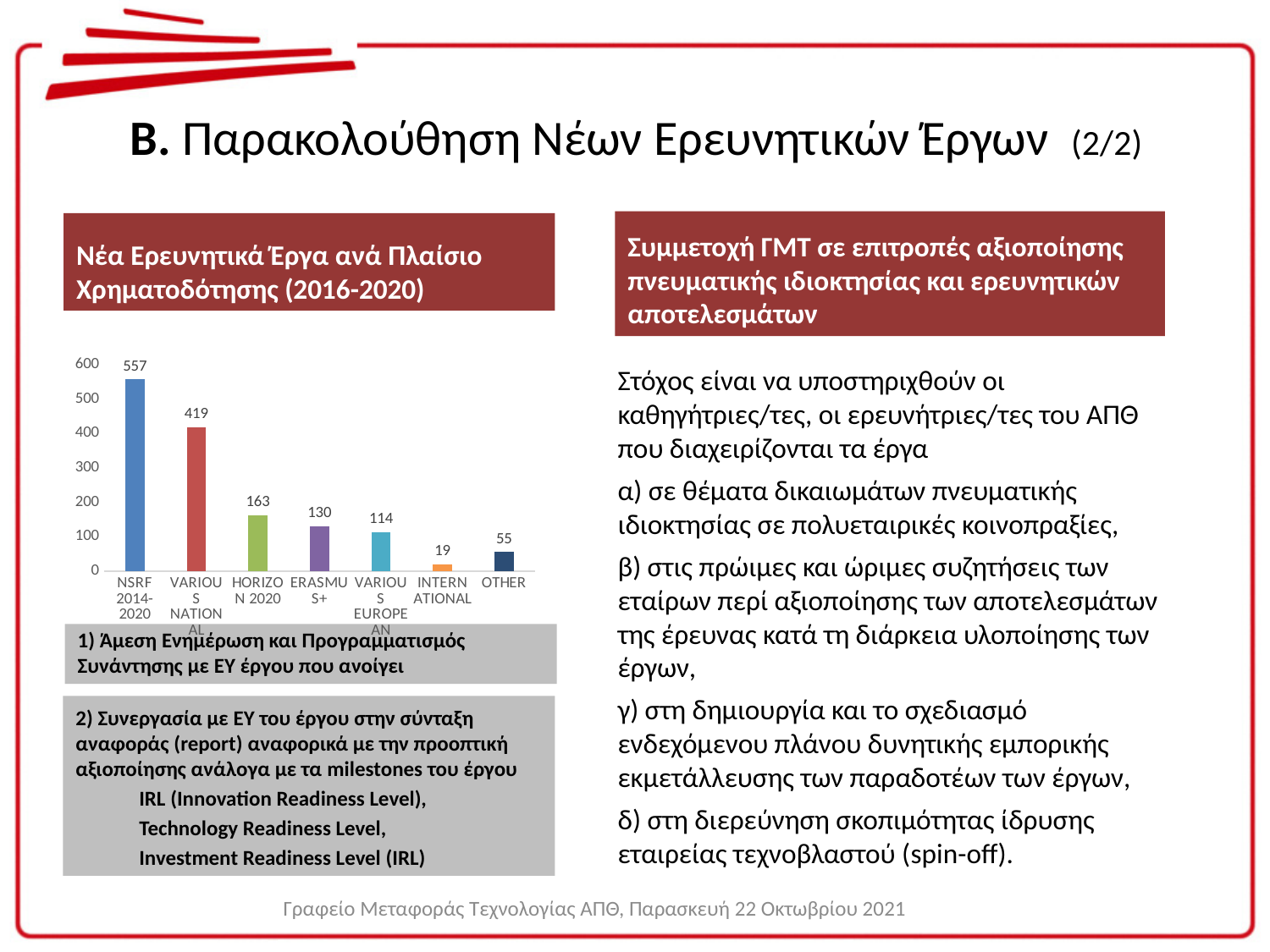
Which category has the lowest value in the chart? INTERNATIONAL Which is larger, the value for OTHER or the value for INTERNATIONAL? OTHER What is the value for ERASMUS+ in the chart? 130 What kind of chart is shown on the slide? bar chart What is the value for INTERNATIONAL in the chart? 19 What is the value for HORIZON 2020 in the chart? 163 Is the value for VARIOUS EUROPEAN greater or less than 100? greater How many categories are shown in the chart? 7 What is the difference between the values for NSRF 2014-2020 and VARIOUS NATIONAL? 138 What is the value for NSRF 2014-2020 in the chart? 557 Which category has the highest value in the chart? NSRF 2014-2020 What is the title of the chart? Νέα Ερευνητικά Έργα ανά Πλαίσιο Χρηματοδότησης (2016-2020)